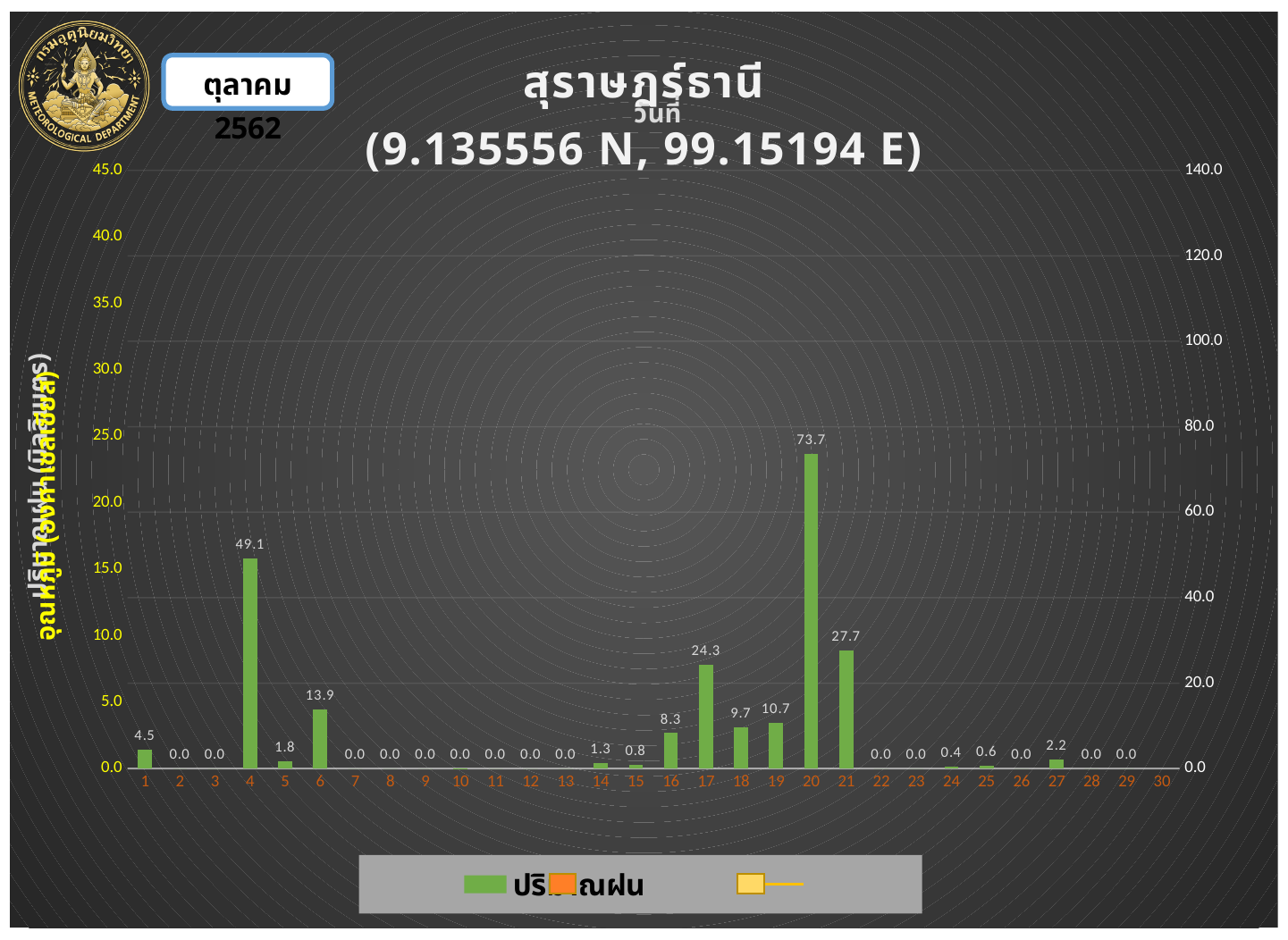
What is the rainfall value shown for day 4? 49.1 What kind of chart is shown on the slide? bar chart Which day has the larger rainfall value, day 18 or day 19? 19 Is the value for day 20 greater or less than 60.0 on the right-hand axis? greater What is the rainfall value shown for day 21? 27.7 What coordinates are given in the chart title? 9.135556 N, 99.15194 E What is the rainfall value shown for day 6? 13.9 What is the difference between the rainfall values for day 20 and day 4? 24.6 What is the difference between the rainfall values for day 21 and day 17? 3.4 How many days are shown on the x axis? 30 What is the rainfall value shown for day 20? 73.7 Which day has the highest rainfall value? 20